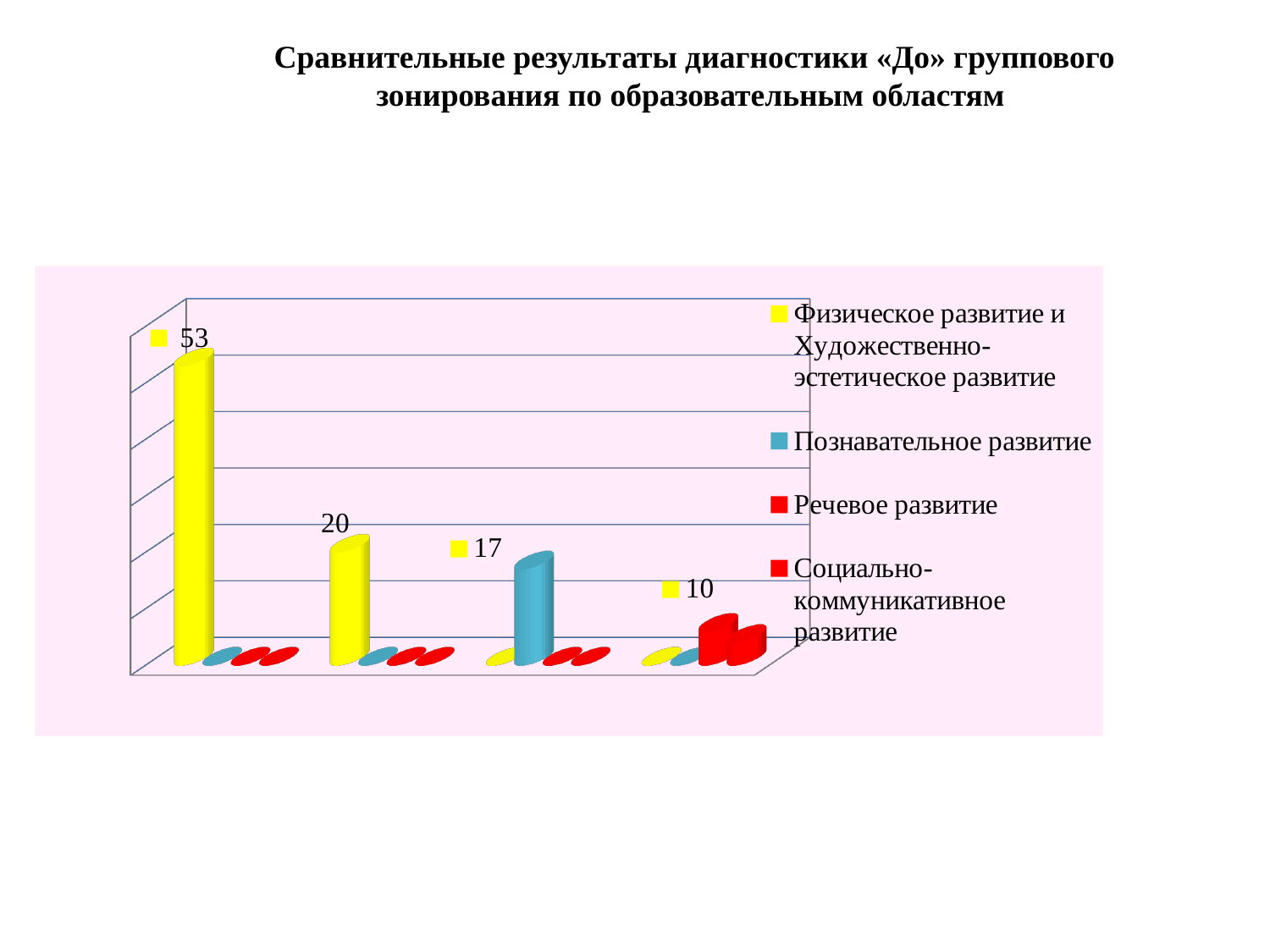
Do the labelled values of the tallest bars rise or fall from left to right across the chart? fall What kind of chart is shown on the slide? bar chart How many groups of bars are plotted on the chart? 4 How many series does the chart legend list? 4 What is the lowest data label value shown on the chart? 10 What is the difference between the data labels 20 and 17 on the chart? 3 Which legend entry is shown in yellow? Физическое развитие и Художественно-эстетическое развитие How many data labels are printed on the chart? 4 What colour is used for the series "Познавательное развитие" in the legend? blue What is the difference between the data labels 53 and 20 on the chart? 33 What is the difference between the highest data label (53) and the lowest data label (10) on the chart? 43 What is the highest data label value shown on the chart? 53